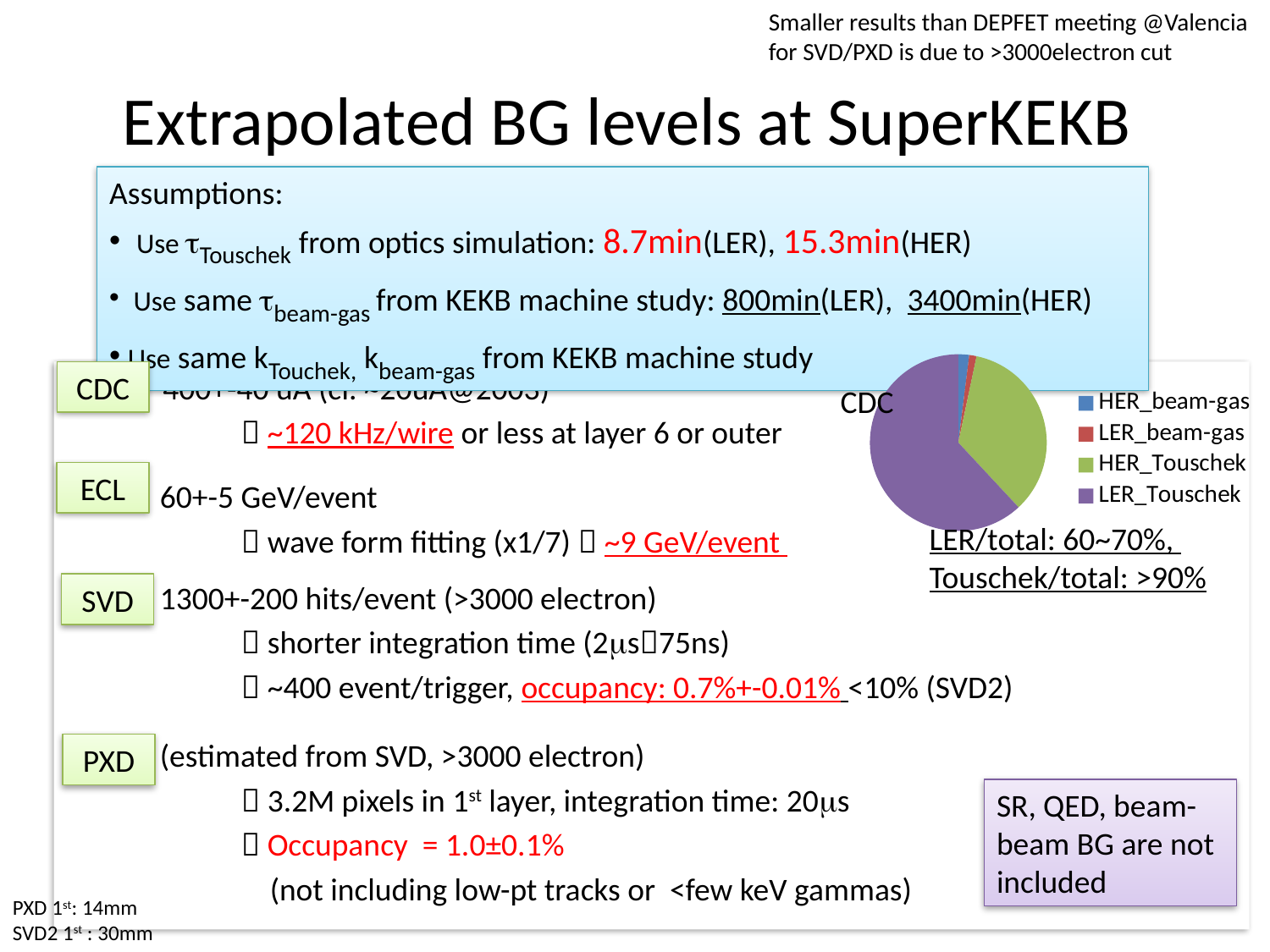
Which slice is larger in the pie chart, LER_Touschek or HER_Touschek? LER_Touschek How many entries does the legend of the pie chart list? 4 Which category has the largest slice in the pie chart? LER_Touschek Which slice is larger in the pie chart, HER_beam-gas or LER_Touschek? LER_Touschek What colour represents LER_Touschek in the pie chart? purple How many slices does the pie chart have? 4 What kind of chart is shown on the slide? pie chart Which slice is larger in the pie chart, HER_Touschek or LER_beam-gas? HER_Touschek